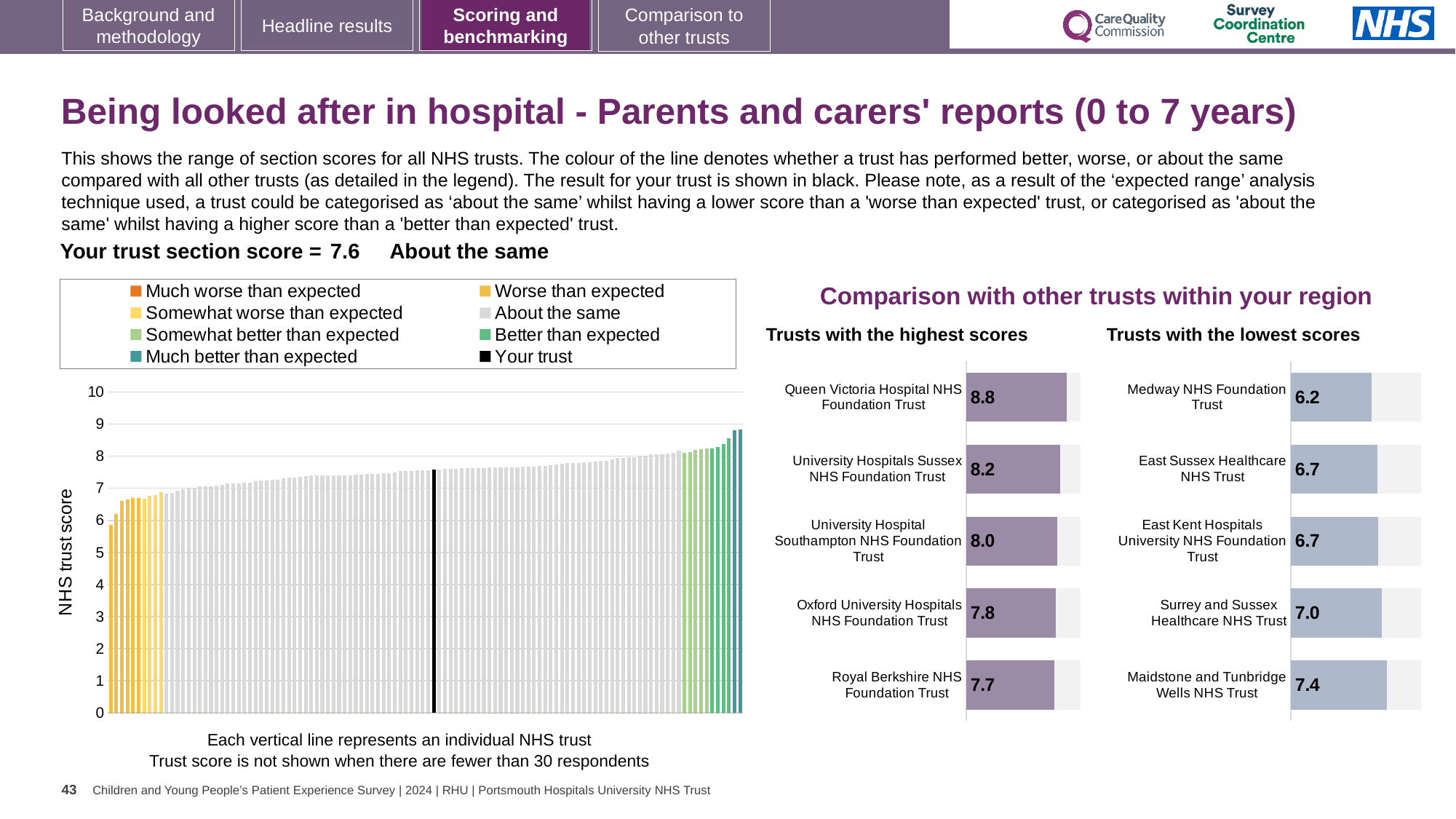
How many entries does the legend of the main chart on the left list? 8 In the 'Trusts with the lowest scores' chart, what is the difference between the scores of Maidstone and Tunbridge Wells NHS Trust and Medway NHS Foundation Trust? 1.2 How many trusts are listed in the 'Trusts with the lowest scores' chart? 5 In the 'Trusts with the highest scores' chart, what is the score for Queen Victoria Hospital NHS Foundation Trust? 8.8 What type of chart is the main chart on the left showing NHS trust scores? Bar chart Which has a higher score: Oxford University Hospitals NHS Foundation Trust in the highest scores chart or Surrey and Sussex Healthcare NHS Trust in the lowest scores chart? Oxford University Hospitals NHS Foundation Trust In the 'Trusts with the lowest scores' chart, which trust has the highest score shown? Maidstone and Tunbridge Wells NHS Trust In the 'Trusts with the highest scores' chart, what is the score for Oxford University Hospitals NHS Foundation Trust? 7.8 In the 'Trusts with the lowest scores' chart, what is the score for Medway NHS Foundation Trust? 6.2 In the main chart on the left, do the trust scores rise or fall from left to right? Rise In the 'Trusts with the highest scores' chart, what is the difference between the scores of Queen Victoria Hospital NHS Foundation Trust and Royal Berkshire NHS Foundation Trust? 1.1 In the 'Trusts with the highest scores' chart, which trust has the lowest score shown? Royal Berkshire NHS Foundation Trust